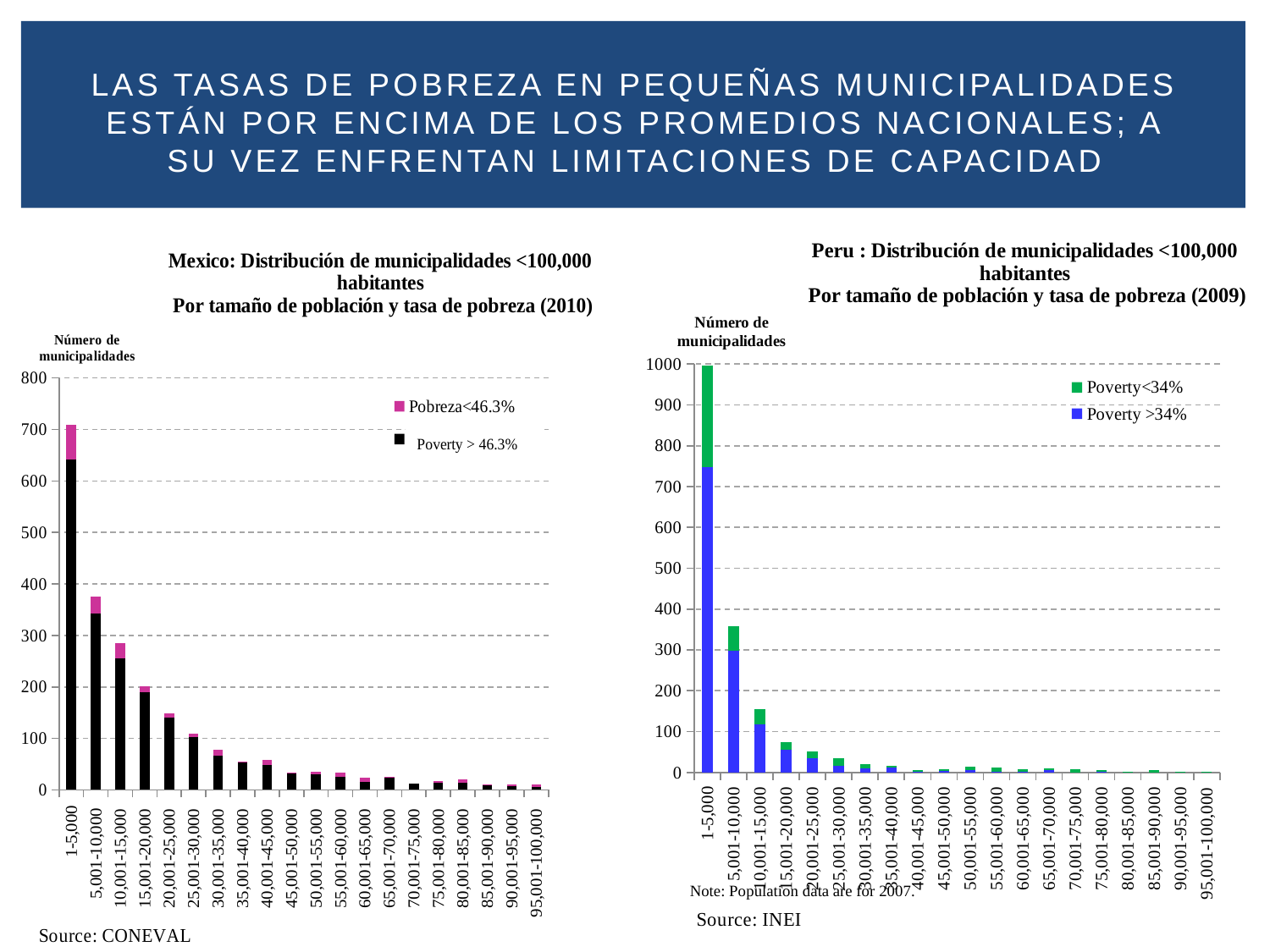
On the Peru chart, is the total number of municipalities for 1-5,000 greater or less than 900? greater What kind of chart is the Peru chart? Stacked bar chart On the Mexico chart, is the total number of municipalities for 30,001-35,000 greater or less than 100? less What are the two legend entries on the Peru chart? Poverty<34% and Poverty >34% How many series does the legend of the Mexico chart list? 2 How many population-size categories are shown on the Peru chart? 20 On the Mexico chart, is the total number of municipalities for 1-5,000 greater or less than 600? greater On the Peru chart, which population-size category has the highest number of municipalities? 1-5,000 On the Mexico chart, do the total numbers of municipalities generally rise or fall as population size increases along the x axis? Fall On the Mexico chart, which population-size category has the highest number of municipalities? 1-5,000